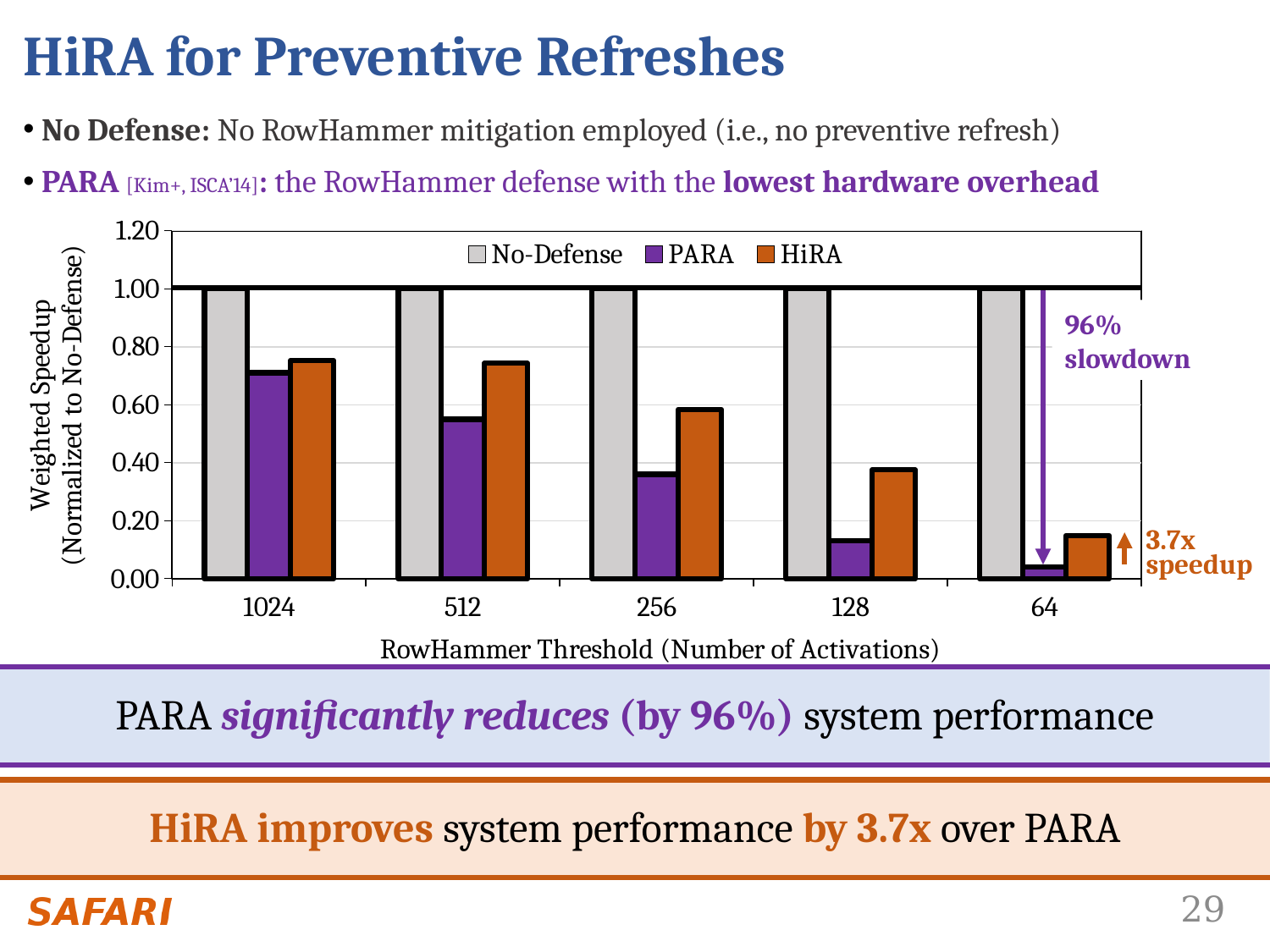
What is the x-axis title of the chart? RowHammer Threshold (Number of Activations) At a RowHammer threshold of 256, which is larger, the PARA bar or the HiRA bar? HiRA How many series does the chart's legend list? 3 At which RowHammer threshold is the PARA bar lowest? 64 What speedup does the annotation at the 64 threshold attribute to HiRA over PARA? 3.7x What is the weighted speedup value for No-Defense at a RowHammer threshold of 1024? 1.00 Do the PARA values rise or fall moving from left to right along the x axis? fall Is the HiRA value at a RowHammer threshold of 64 greater or less than 0.20? less Is the PARA value at a RowHammer threshold of 1024 greater or less than 0.60? greater What kind of chart is shown on the slide? bar chart How many RowHammer threshold categories are shown on the x axis? 5 Is the PARA value at a RowHammer threshold of 512 greater or less than 0.60? less